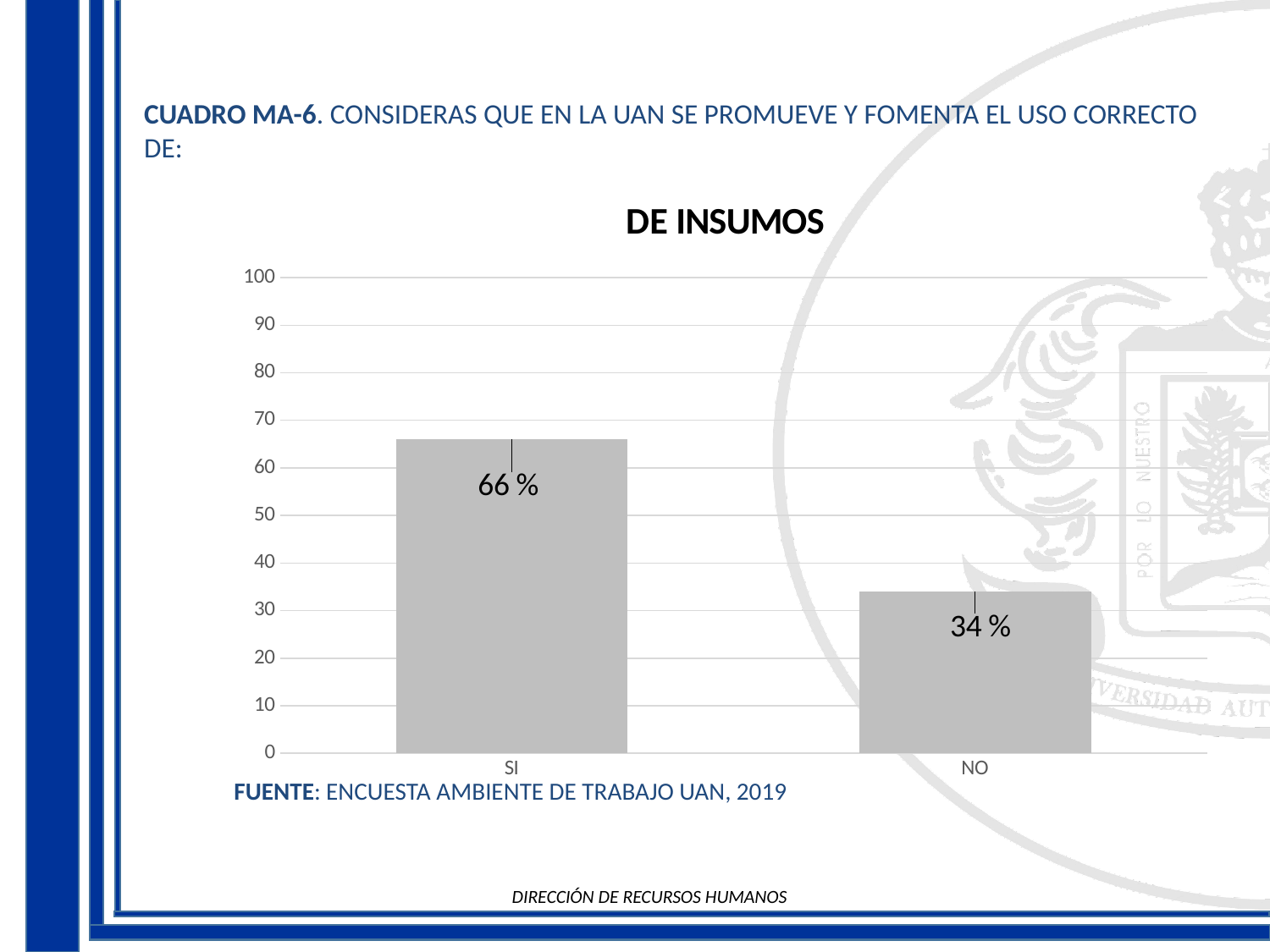
Which category has the highest value? SI How many categories are shown on the x axis? 2 What is the highest value shown on the y axis? 100 What is the value for SI? 66 % What is the title of the chart? DE INSUMOS What is the value for NO? 34 % Is the value for NO greater or less than 40? less What is the difference between the values for SI and NO? 32 % What kind of chart is shown? bar chart Which category has the lowest value? NO Is the value for SI greater or less than 60? greater Which is larger, the value for SI or the value for NO? SI